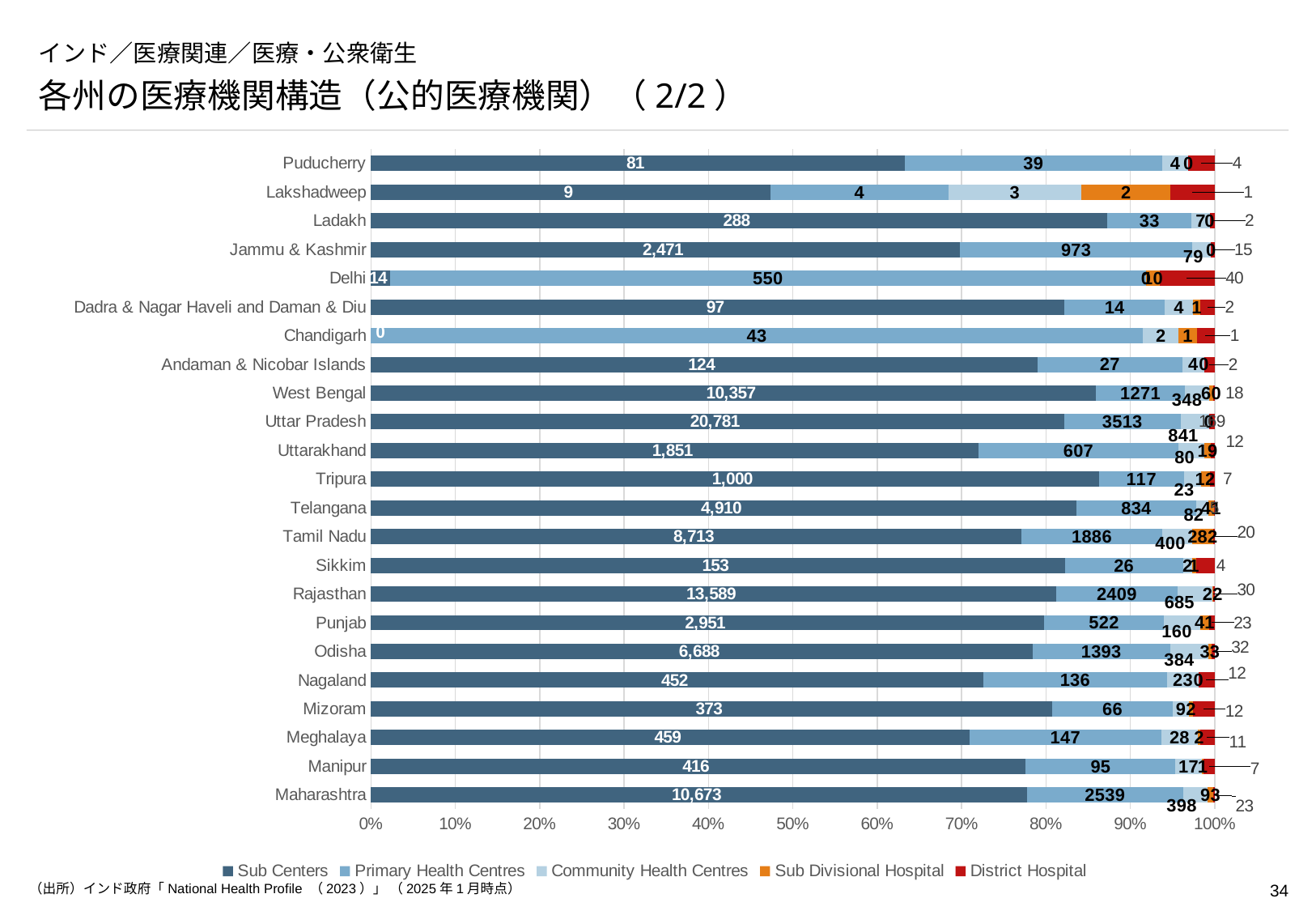
Which has the larger Primary Health Centres value, Rajasthan or Tamil Nadu? Rajasthan How many states or territories are plotted on the chart? 23 Which state or territory has the lowest Sub Centers value? Chandigarh What is the difference between the Sub Centers values of Maharashtra and West Bengal? 316 What is the Sub Centers value for Uttar Pradesh? 20,781 What is the Community Health Centres value for Rajasthan? 685 What is the District Hospital value for Delhi? 40 Which state has the highest Sub Centers value? Uttar Pradesh Which series is shown in orange in the legend? Sub Divisional Hospital What kind of chart is shown on the slide? Stacked bar chart How many series does the legend list? 5 What is the Primary Health Centres value for Maharashtra? 2539